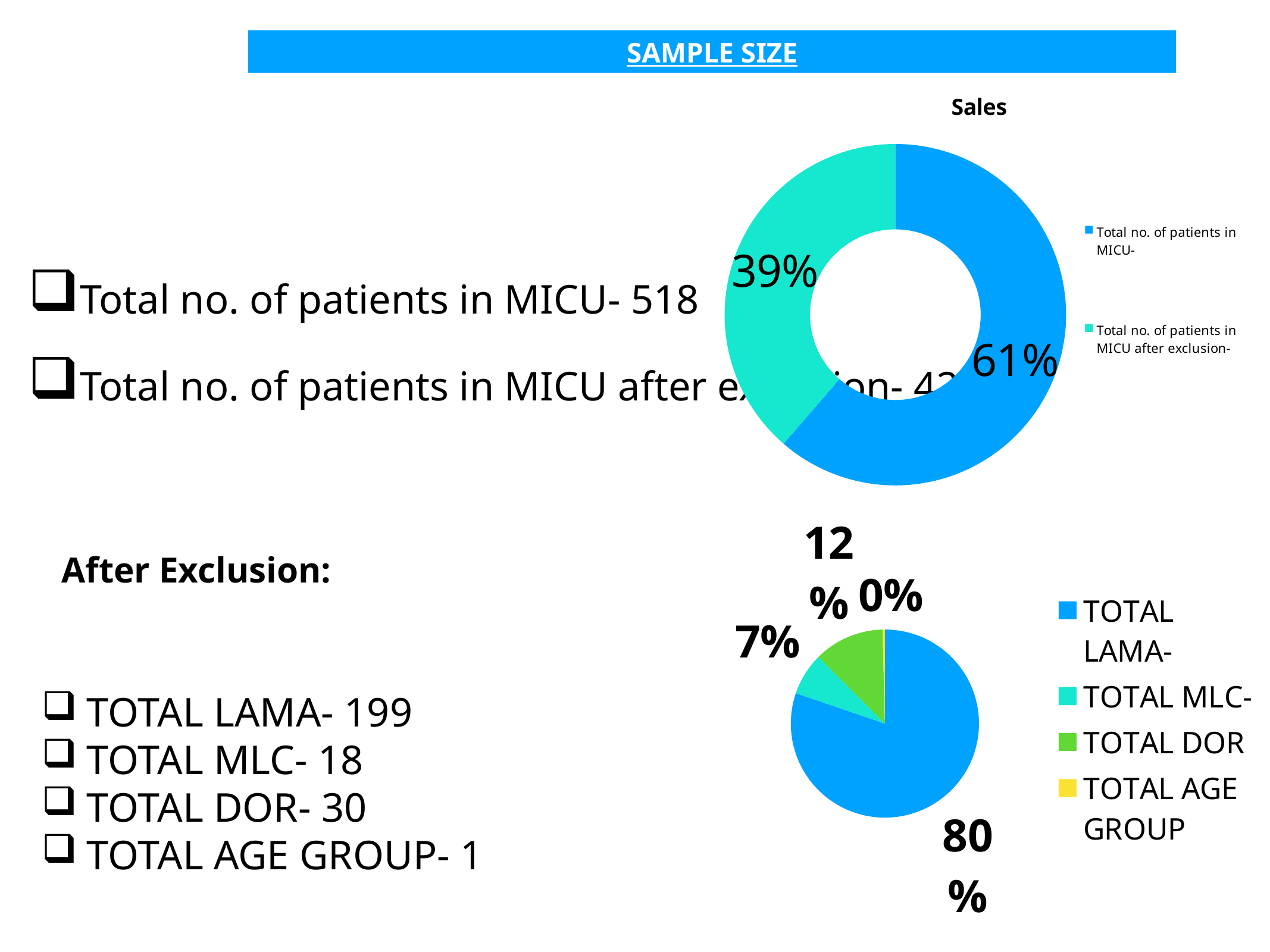
On the bottom pie chart, what percentage is shown for TOTAL LAMA-? 80% On the top chart titled "Sales", how many entries does the legend list? 2 On the bottom pie chart, what is the difference in percentage points between TOTAL LAMA- and TOTAL DOR? 68 On the bottom pie chart, which category has the smallest share? TOTAL AGE GROUP On the bottom pie chart, how many categories does the legend list? 4 On the top chart titled "Sales", what percentage is shown for "Total no. of patients in MICU after exclusion-"? 39% On the bottom pie chart, which is larger, TOTAL DOR or TOTAL MLC-? TOTAL DOR On the bottom pie chart, what percentage is shown for TOTAL MLC-? 7% On the top chart titled "Sales", which slice is the largest? Total no. of patients in MICU- What kind of chart is the top chart titled "Sales"? Doughnut chart On the top chart titled "Sales", what percentage is shown for "Total no. of patients in MICU-"? 61% On the bottom pie chart, what percentage is shown for TOTAL DOR? 12%